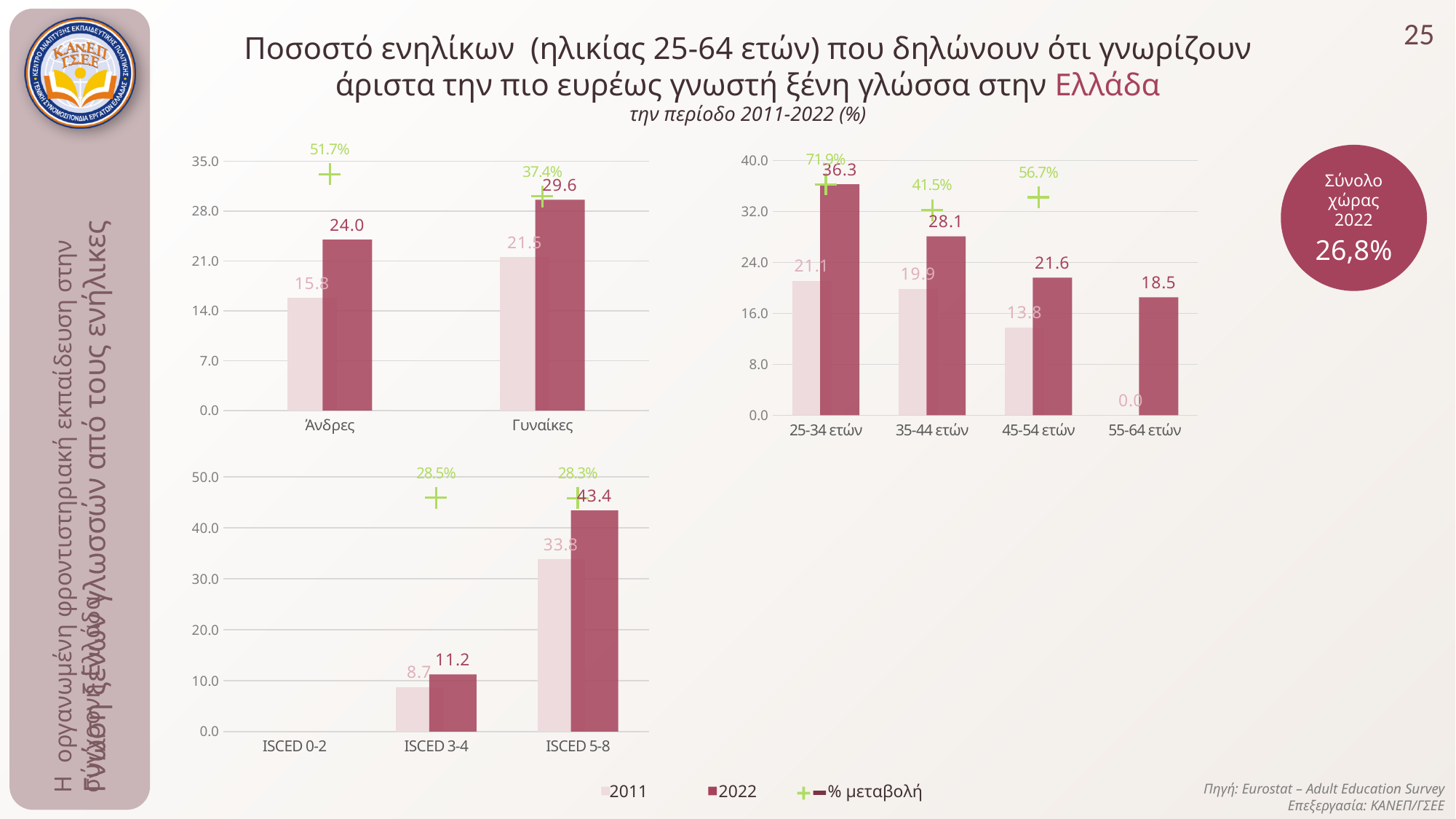
In the bottom-left chart (by education level), what is the difference between the 2022 and 2011 values for ISCED 3-4? 2.5 In the top-right chart (by age group), which age group has the highest 2022 value? 25-34 ετών In the top-left chart (by gender), what is the 2011 value for Γυναίκες? 21.5 What type of chart is the top-right chart (by age group)? Bar chart In the top-right chart (by age group), what is the 2022 value for 55-64 ετών? 18.5 In the top-right chart (by age group), what is the % μεταβολή shown for 45-54 ετών? 56.7% In the top-left chart (by gender), what is the % μεταβολή shown for Άνδρες? 51.7% In the top-left chart (by gender), what is the 2022 value for Άνδρες? 24.0 How many series does the legend at the bottom of the slide list? 3 In the top-right chart (by age group), which is larger: the 2011 value for 35-44 ετών or the 2011 value for 45-54 ετών? 35-44 ετών In the bottom-left chart (by education level), what is the 2022 value for ISCED 5-8? 43.4 In the top-left chart (by gender), what is the difference between the 2022 and 2011 values for Γυναίκες? 8.1